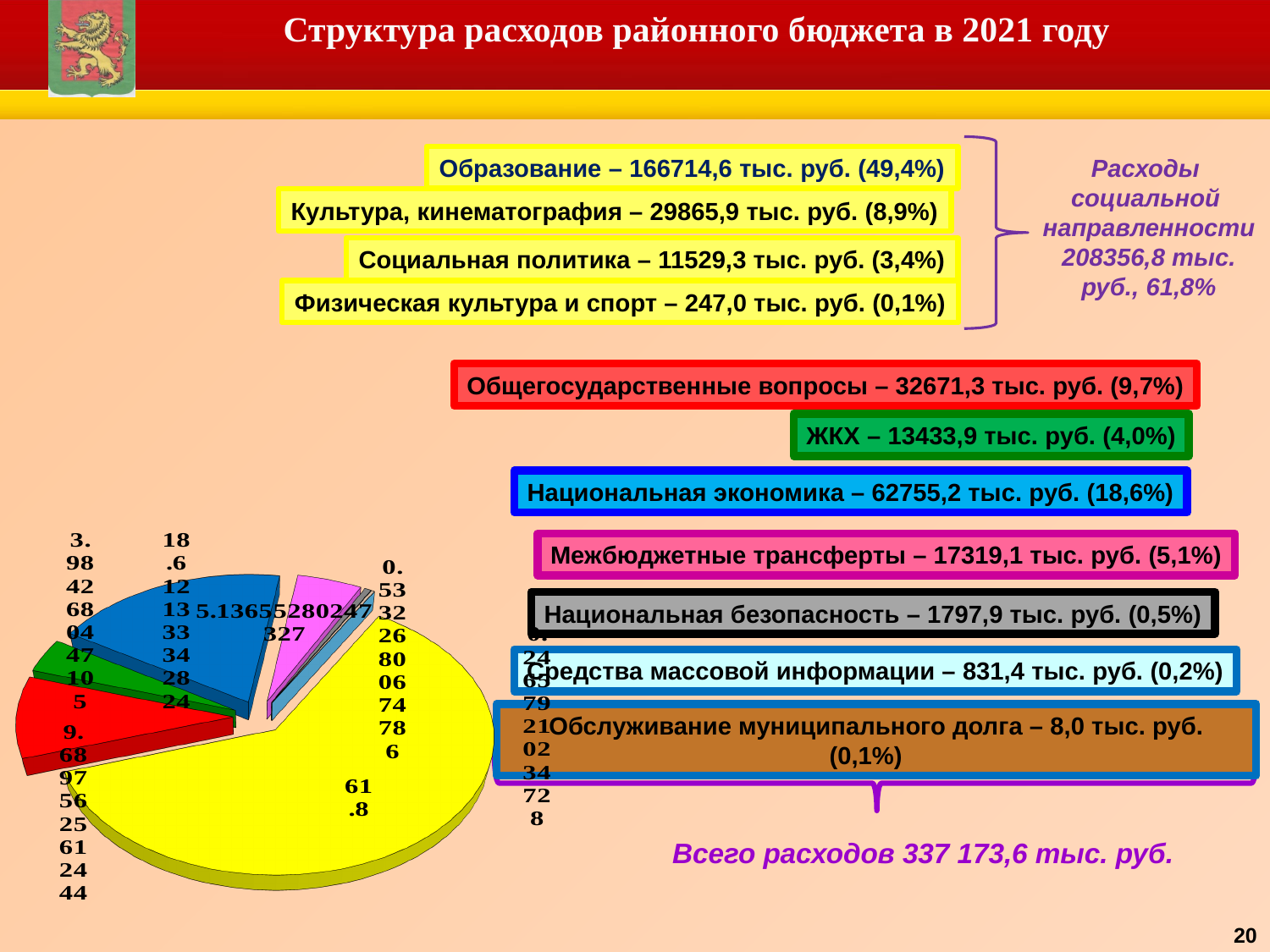
What kind of chart is shown on the slide? pie chart What colour is the largest slice of the pie? yellow What share of expenditures is Национальная экономика? 18,6% What amount is given for ЖКХ? 13433,9 тыс. руб. (4,0%) What is the title of the slide containing the chart? Структура расходов районного бюджета в 2021 году Which expenditure group has the largest slice of the pie? Расходы социальной направленности (61,8%) What amount is given for Обслуживание муниципального долга? 8,0 тыс. руб. (0,1%) Which is larger: Национальная экономика or Общегосударственные вопросы? Национальная экономика What is the total amount of expenditures stated on the slide? 337 173,6 тыс. руб. What share of expenditures do Расходы социальной направленности make up? 61,8% What is the difference in percentage share between Национальная экономика (18,6%) and Общегосударственные вопросы (9,7%)? 8,9% What amount is given for Образование? 166714,6 тыс. руб. (49,4%)